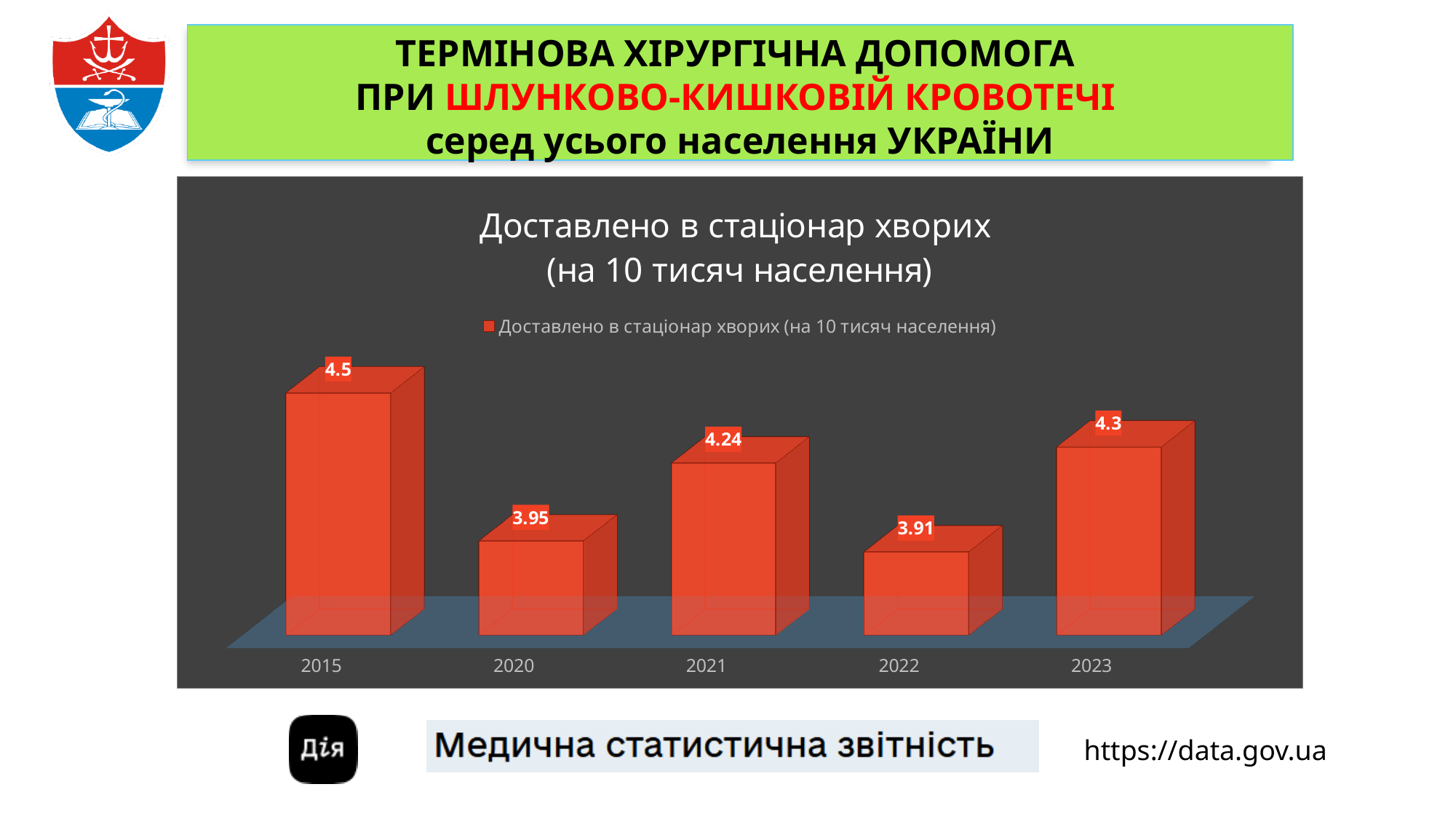
What kind of chart is shown on the slide? bar chart Which year has the lowest value? 2022 How many years are shown on the chart? 5 Which is larger, the value for 2021 or the value for 2023? 2023 What is the value for 2022? 3.91 What is the value for 2023? 4.3 What is the value for 2015? 4.5 What is the value for 2021? 4.24 What is the title of the chart? Доставлено в стаціонар хворих (на 10 тисяч населення) What is the value for 2020? 3.95 What is the difference between the values for 2015 and 2022? 0.59 Which year has the highest value? 2015